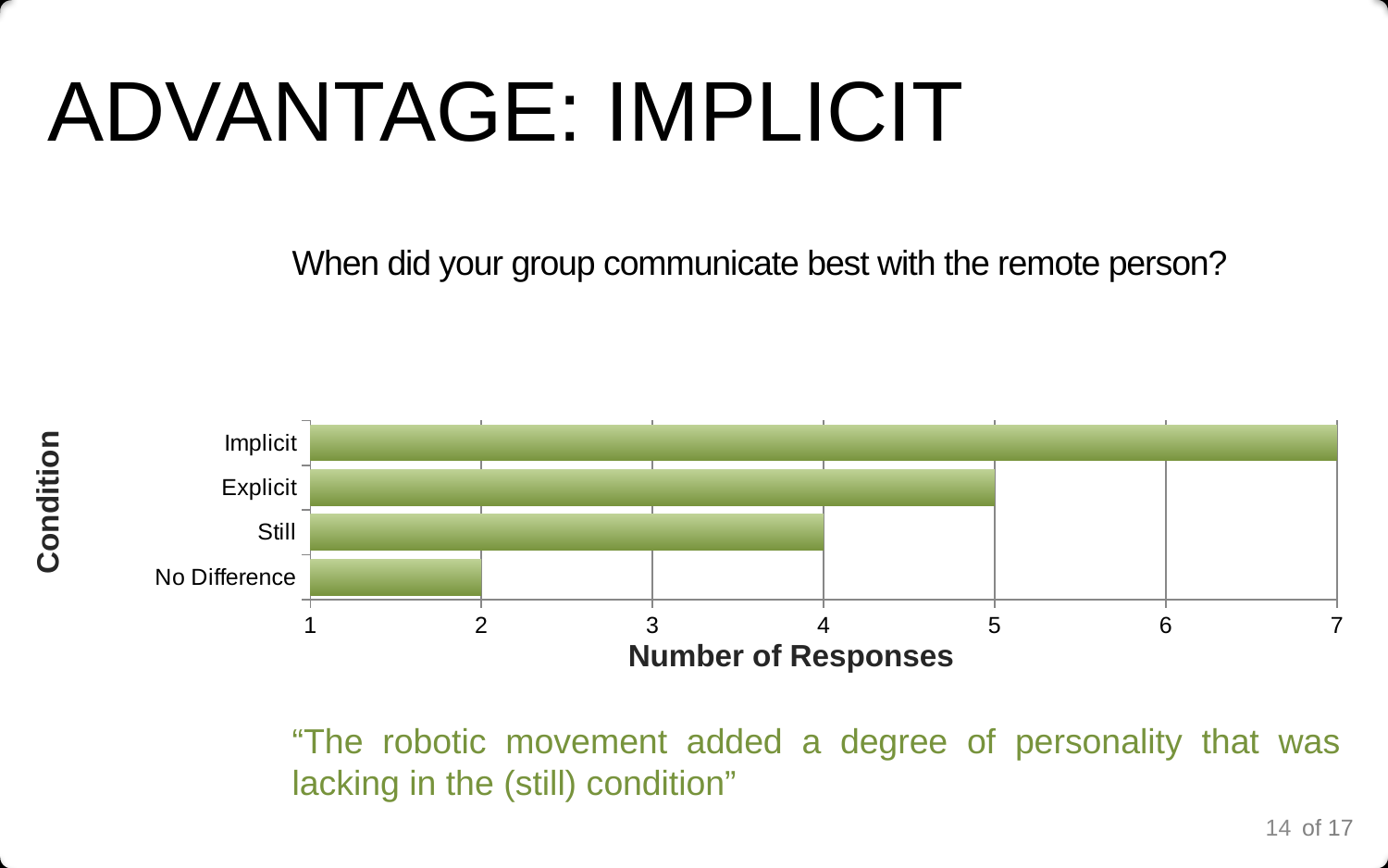
What is the label of the horizontal axis? Number of Responses Which condition received the most responses? Implicit What is the number of responses for the Implicit condition? 7 Which received more responses, Still or Explicit? Explicit What kind of chart is shown on the slide? bar chart How many conditions are shown in the chart? 4 How many more responses did Implicit receive than Explicit? 2 What is the title of the chart? When did your group communicate best with the remote person? What is the number of responses for No Difference? 2 What is the number of responses for the Explicit condition? 5 Which condition received the fewest responses? No Difference What is the number of responses for the Still condition? 4